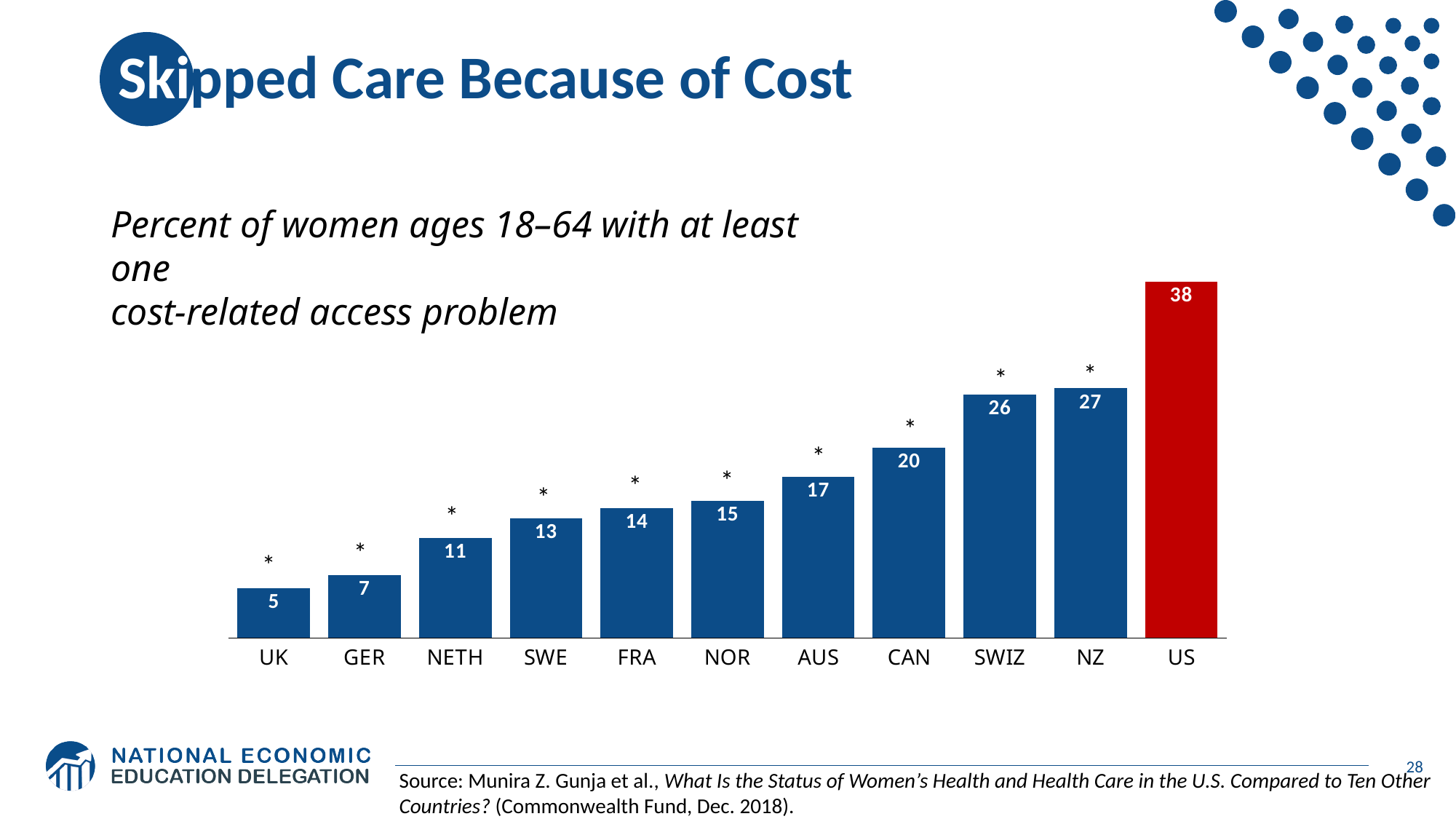
What is the value for the US? 38 What is the difference between the values for the US and NZ? 11 Do the values rise or fall from left to right along the x axis? Rise How many countries are shown on the chart? 11 What kind of chart is shown on the slide? Bar chart Which country has the lowest value? UK What is the difference between the values for SWIZ and UK? 21 What is the value for Germany (GER)? 7 What is the value for Canada (CAN)? 20 Which bar is coloured red rather than blue? US Which country has the highest value? US Which is larger, the value for AUS or the value for FRA? AUS